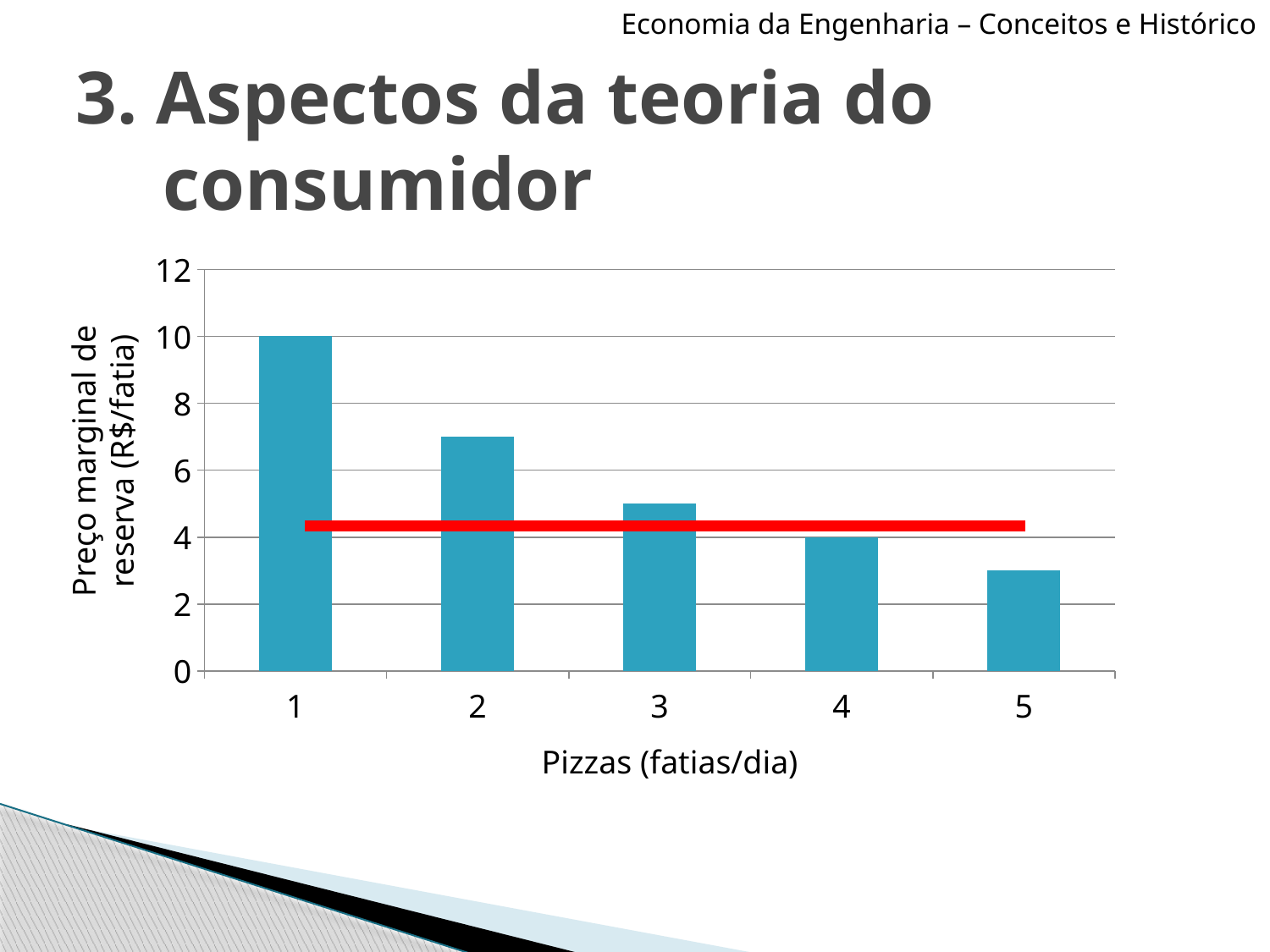
What type of chart is shown on the slide? bar chart Which category has the highest bar? 1 What is the difference between the value for category 1 and the value for category 4? 6 Is the value for category 2 greater or less than 6? greater Which has a larger value, category 2 or category 3? 2 What is the label of the y axis of the chart? Preço marginal de reserva (R$/fatia) What is the value for 4 pizza slices per day (Pizzas (fatias/dia) = 4)? 4 Is the value for category 5 greater or less than 4? less How many categories are shown on the x axis of the chart? 5 Which category has the lowest bar? 5 Do the bar values rise or fall as the number of pizza slices per day increases along the x axis? fall What is the value for 1 pizza slice per day (Pizzas (fatias/dia) = 1)? 10